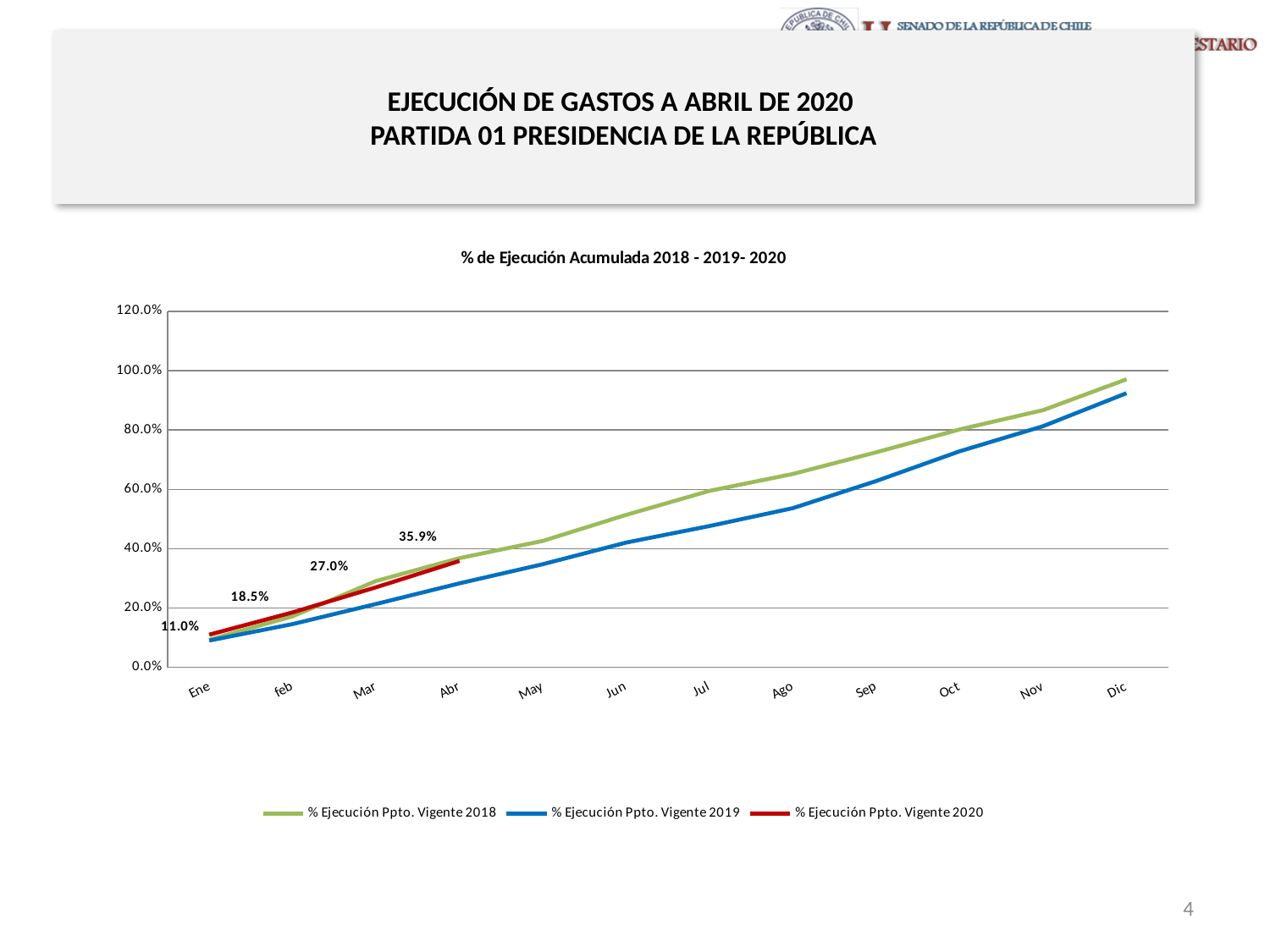
Do the values of % Ejecución Ppto. Vigente 2019 rise or fall from Ene to Dic? Rise What is the difference between the 2020 values for Feb and Ene? 7.5% Which series has the higher value in Dic, 2018 or 2019? % Ejecución Ppto. Vigente 2018 What is the difference between the 2020 values for Abr and Mar? 8.9% How many months are shown on the x axis? 12 What kind of chart is shown on the slide? Line chart What is the value of % Ejecución Ppto. Vigente 2020 for Abr? 35.9% Is the value for % Ejecución Ppto. Vigente 2019 in Jul greater or less than 60.0%? less How many series does the legend list? 3 What is the value of % Ejecución Ppto. Vigente 2020 for Ene? 11.0% Is the value for % Ejecución Ppto. Vigente 2018 in Dic greater or less than 80.0%? greater What is the value of % Ejecución Ppto. Vigente 2020 for Mar? 27.0%